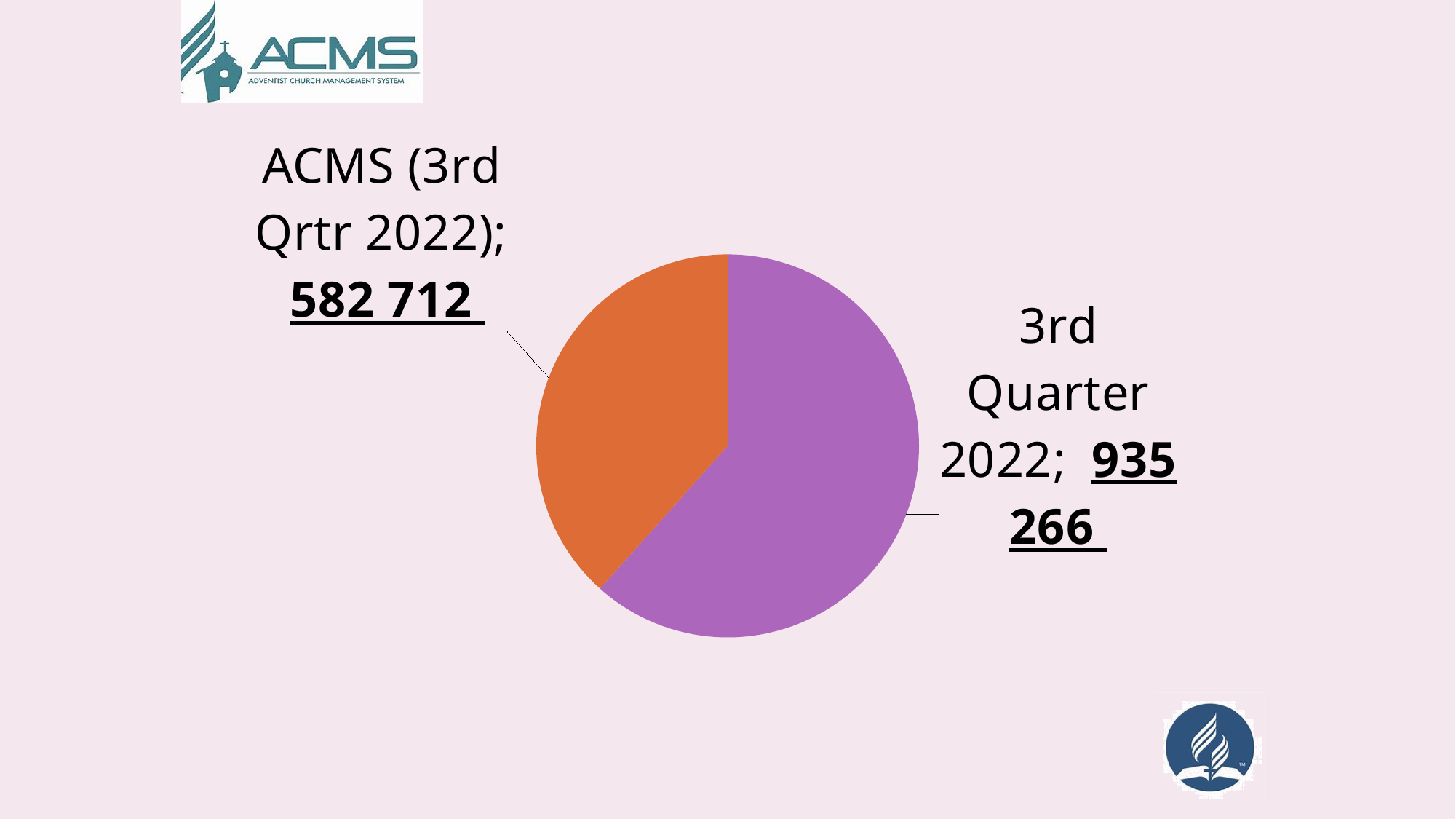
Which slice has the largest value? 3rd Quarter 2022 What colour is the slice for 3rd Quarter 2022? Purple What is the difference between the value for 3rd Quarter 2022 and the value for ACMS (3rd Qrtr 2022)? 352 554 What is the value for ACMS (3rd Qrtr 2022)? 582 712 What is the value for 3rd Quarter 2022? 935 266 What is the total of the two slices in the pie chart? 1 517 978 What type of chart is shown on the slide? Pie chart How many slices does the pie chart have? 2 Which is larger, the value for 3rd Quarter 2022 or the value for ACMS (3rd Qrtr 2022)? 3rd Quarter 2022 Which slice has the smallest value? ACMS (3rd Qrtr 2022) What share of the pie does the ACMS (3rd Qrtr 2022) slice represent, to one decimal place? 38.4% What colour is the slice for ACMS (3rd Qrtr 2022)? Orange